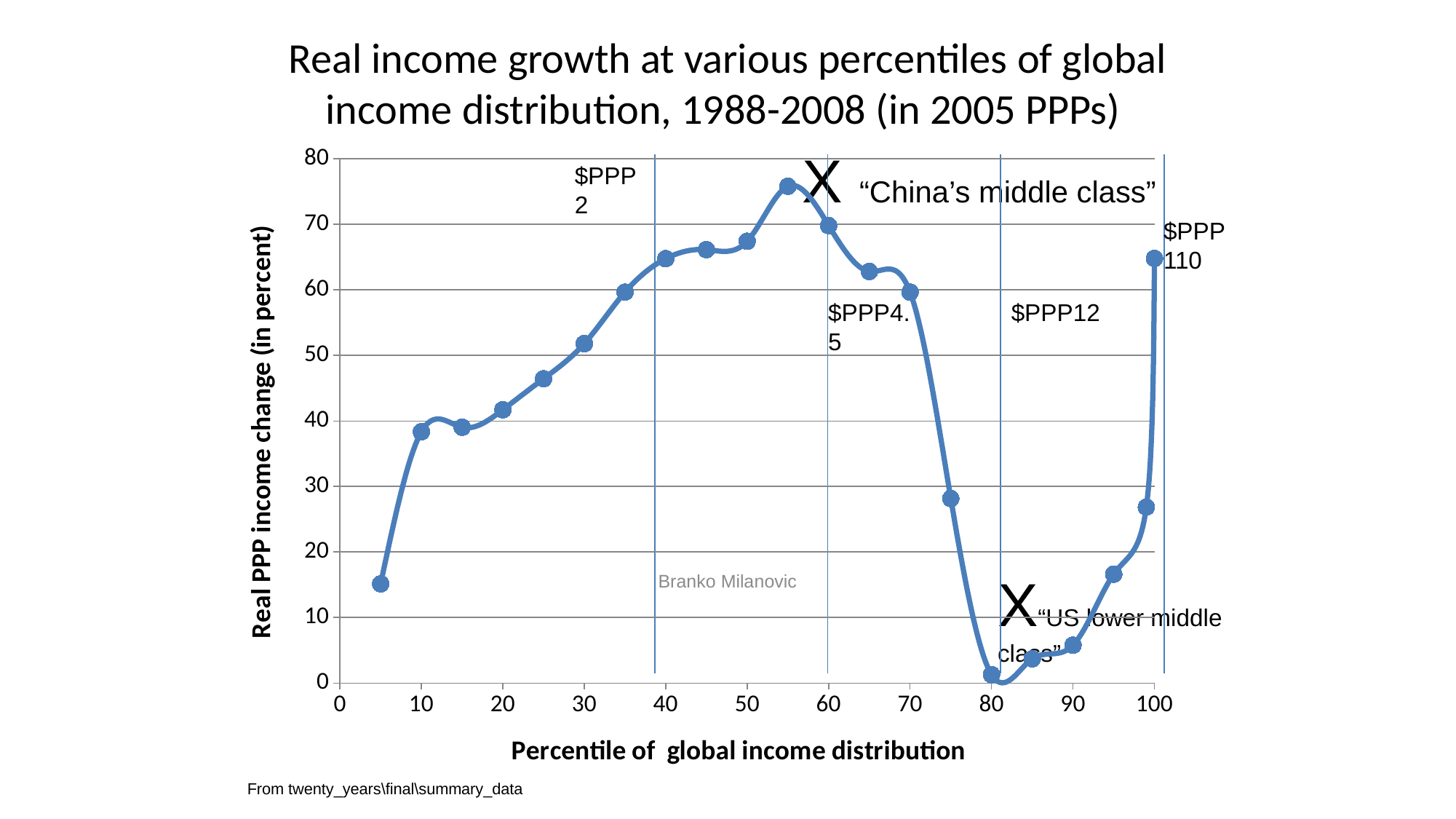
Is the real PPP income change at the 100th percentile greater or less than 60? greater Which has the larger real PPP income change: the 20th percentile or the 70th percentile? 70th percentile Is the real PPP income change at the 5th percentile greater or less than 20? less Is the real PPP income change at the 75th percentile greater or less than 40? less What kind of chart is shown on the slide? line chart Does the real PPP income change rise or fall as the percentile goes from 55 to 80? fall What is the title of the x axis? Percentile of global income distribution At which percentile of the global income distribution is the real PPP income change lowest? 80 Which has the larger real PPP income change: the 99th percentile or the 100th percentile? 100th percentile At which percentile of the global income distribution is the real PPP income change highest? 55